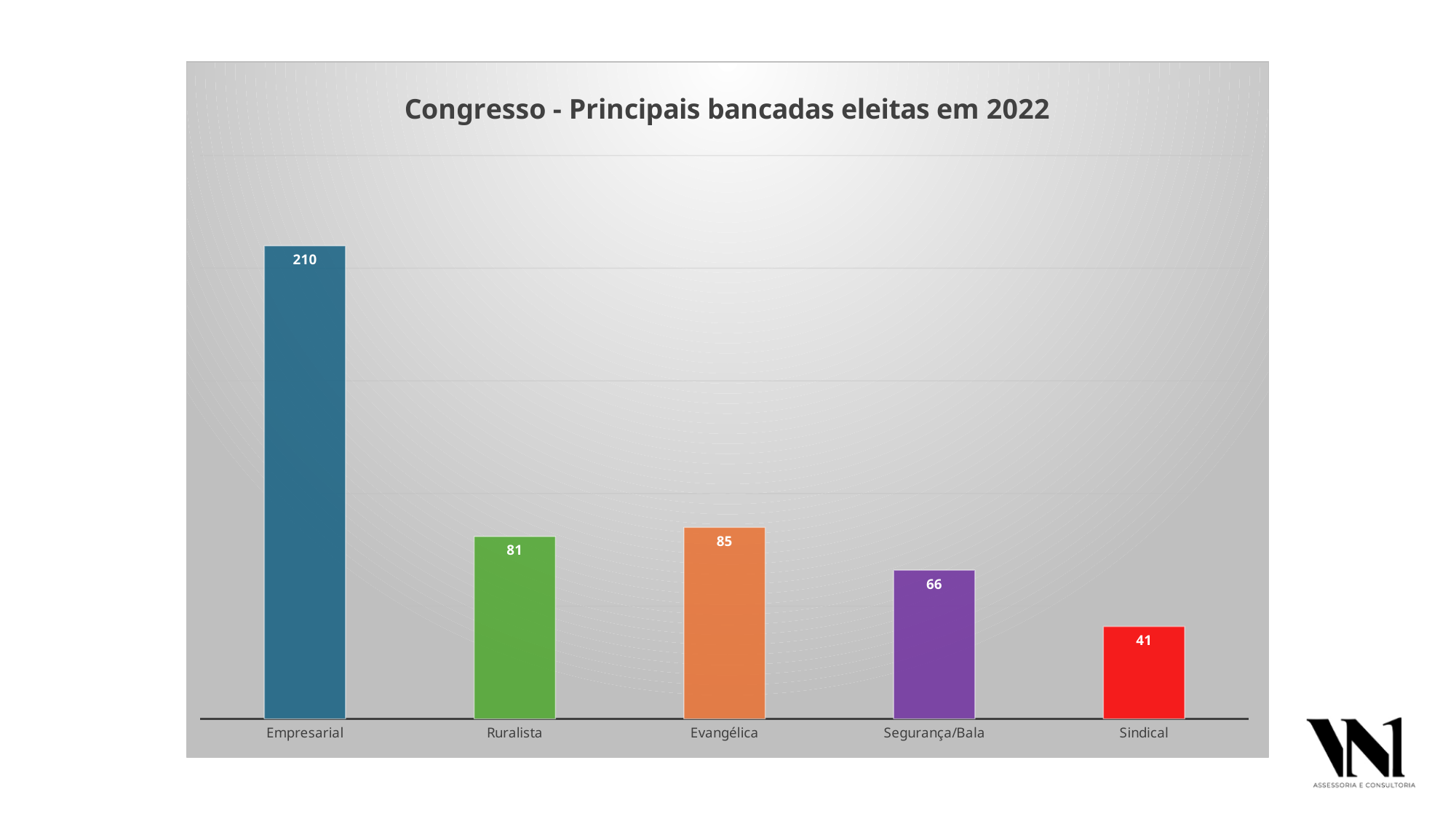
What is the value for Sindical? 41 How many categories are shown on the chart? 5 What is the value for Segurança/Bala? 66 What is the title of the chart? Congresso - Principais bancadas eleitas em 2022 What is the value for Evangélica? 85 Which category has the lowest value? Sindical Which is larger, the value for Ruralista or the value for Segurança/Bala? Ruralista Which category has the highest value? Empresarial What is the value for Ruralista? 81 What kind of chart is shown on the slide? Bar chart What is the value for Empresarial? 210 What is the difference between the values for Empresarial and Evangélica? 125